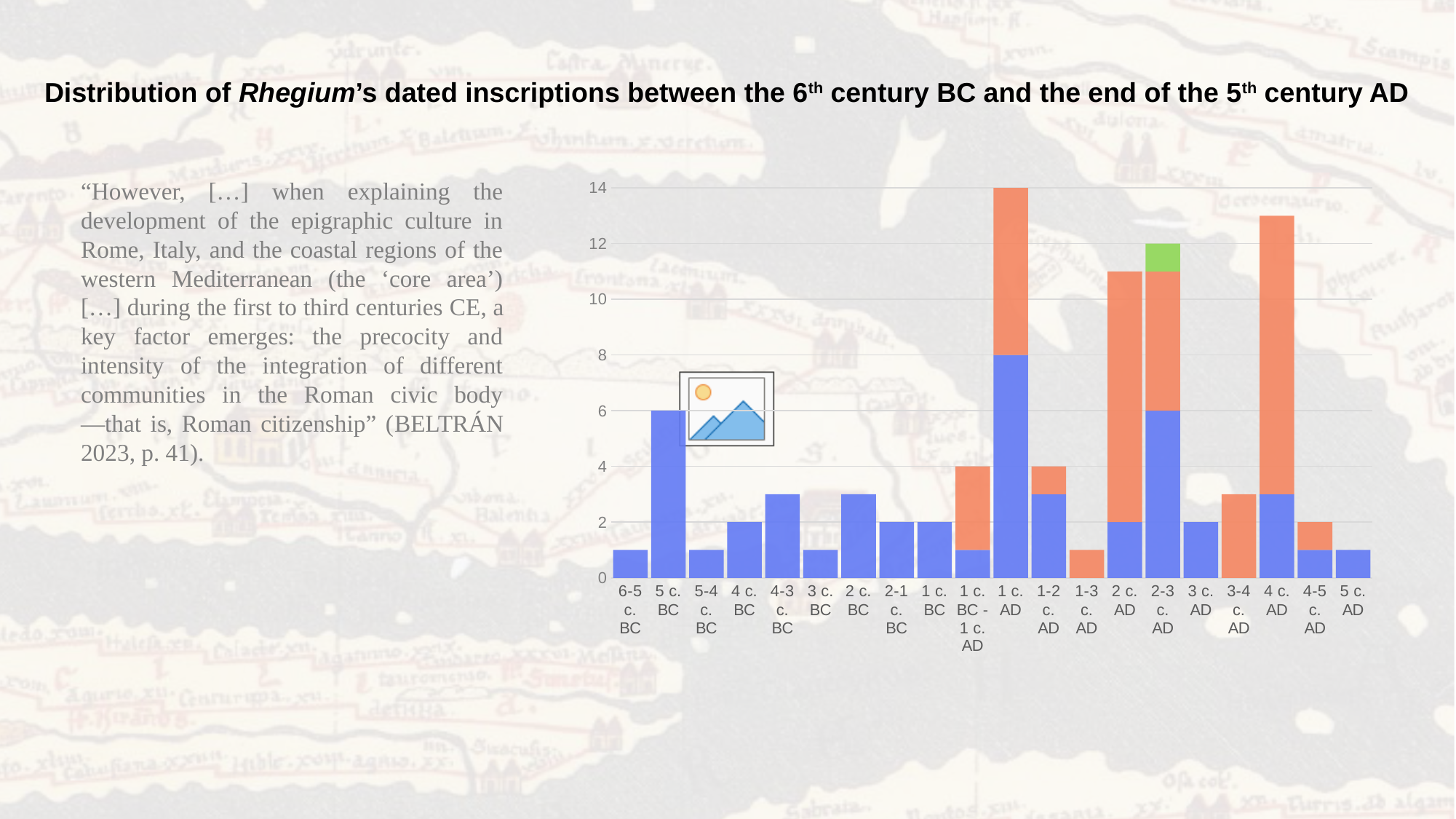
Which period has the tallest bar in the chart? 1 c. AD How many categories (periods) are shown along the x axis of the chart? 20 What is the total height of the bar for 1 c. AD? 14 What kind of chart is shown on the slide? Stacked bar chart What is the total height of the bar for 5 c. BC? 6 What is the total height of the stacked bar for 2-3 c. AD? 12 What is the difference between the total for 1 c. AD and the total for 5 c. BC? 8 Is the value for 5-4 c. BC greater or less than 2? less Which bar is taller, 5 c. BC or 4 c. BC? 5 c. BC Is the total value for 2 c. AD greater or less than 10? greater What is the value of the bar for 3 c. AD? 2 Which bar is the only one that includes a green segment? 2-3 c. AD